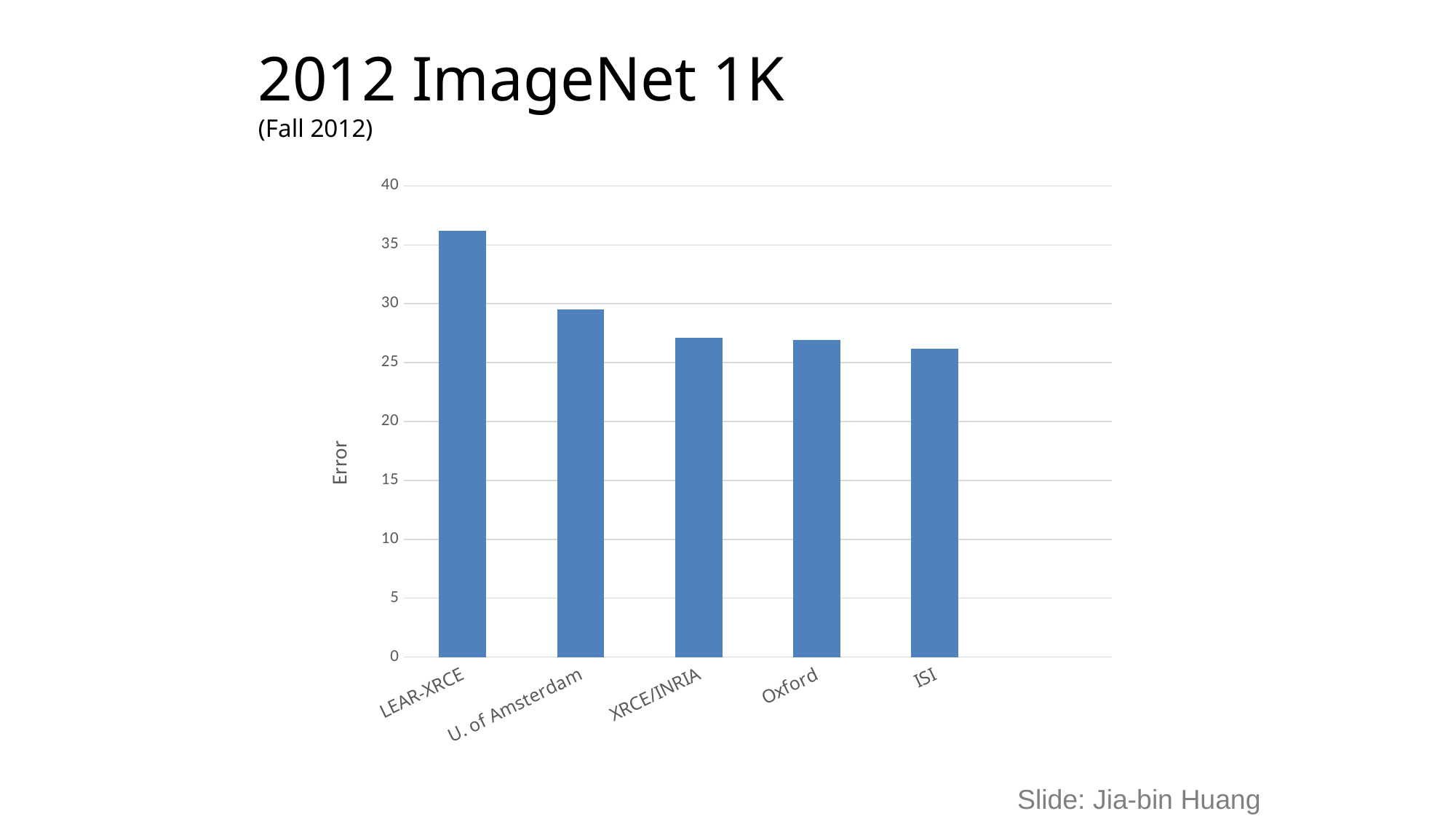
What is the label on the vertical axis of the chart? Error Do the error values rise or fall moving from left to right across the teams? fall Is the error for XRCE/INRIA greater or less than 30? less What kind of chart is shown on the slide? bar chart Which team has the highest error in the chart? LEAR-XRCE Is the error for LEAR-XRCE greater or less than 35? greater How many teams (categories) are plotted in the chart? 5 Is the error for Oxford greater or less than 30? less Which has a higher error, U. of Amsterdam or Oxford? U. of Amsterdam Which has a higher error, LEAR-XRCE or ISI? LEAR-XRCE